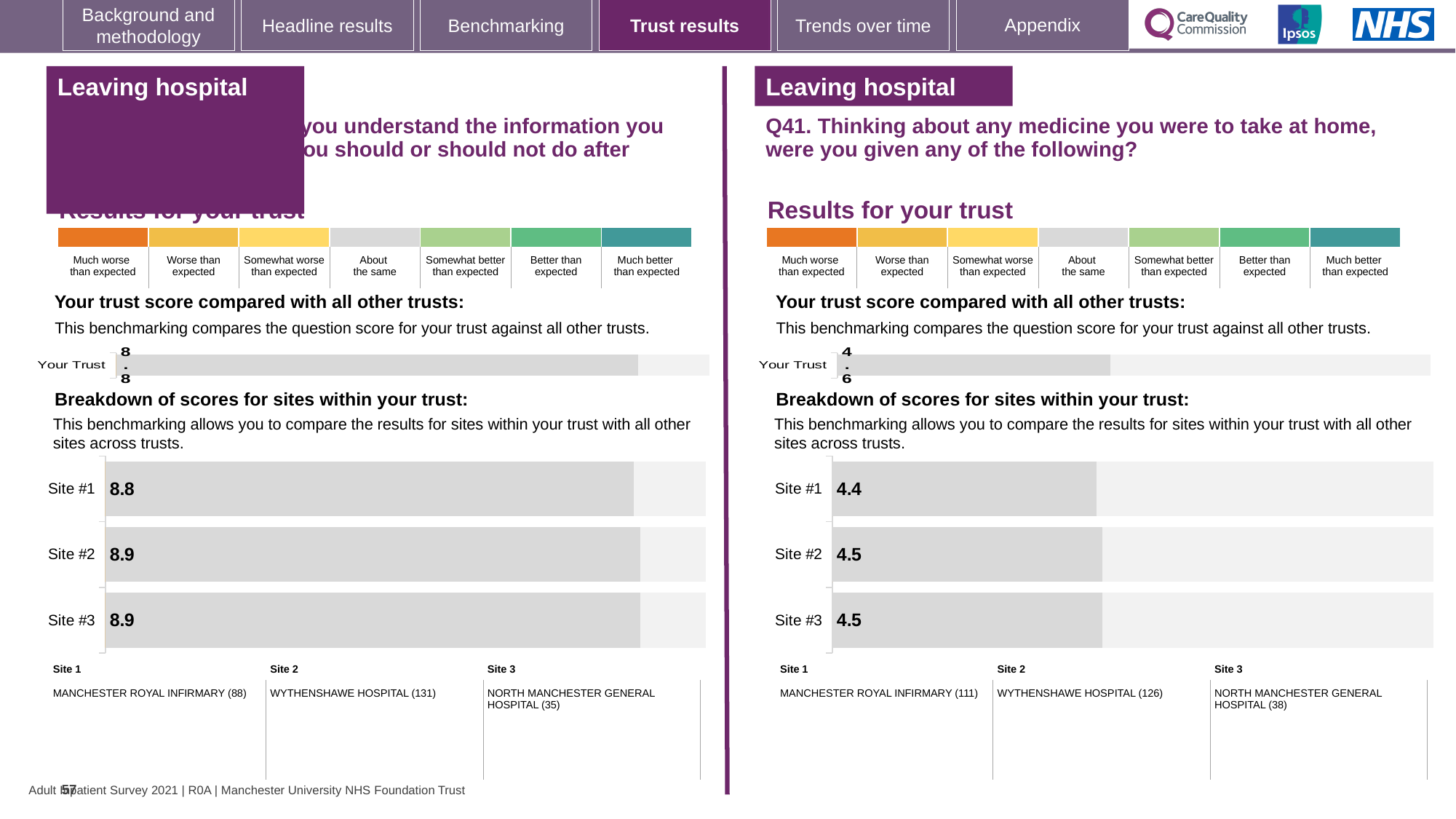
In the left-hand site breakdown chart, which site has the lowest score? Site #1 In the left-hand site breakdown chart, what is the score for Site #2? 8.9 What type of chart is used for the site breakdown on the left-hand side of the slide? bar chart In the left-hand site breakdown chart, what is the score for Site #1? 8.8 In the Q41 site breakdown chart on the right, what is the difference between the scores for Site #2 and Site #1? 0.1 In the left-hand 'Your trust score compared with all other trusts' chart, what is the score for Your Trust? 8.8 How many sites are shown in the Q41 site breakdown chart on the right? 3 In the Q41 site breakdown chart on the right, what is the score for Site #1? 4.4 In the Q41 site breakdown chart on the right, what is the score for Site #3? 4.5 In the left-hand site breakdown chart, is the score for Site #2 larger or smaller than the score for Site #1? larger In the Q41 'Your trust score compared with all other trusts' chart on the right, what is the score for Your Trust? 4.6 In the Q41 site breakdown chart on the right, which site has the lowest score? Site #1